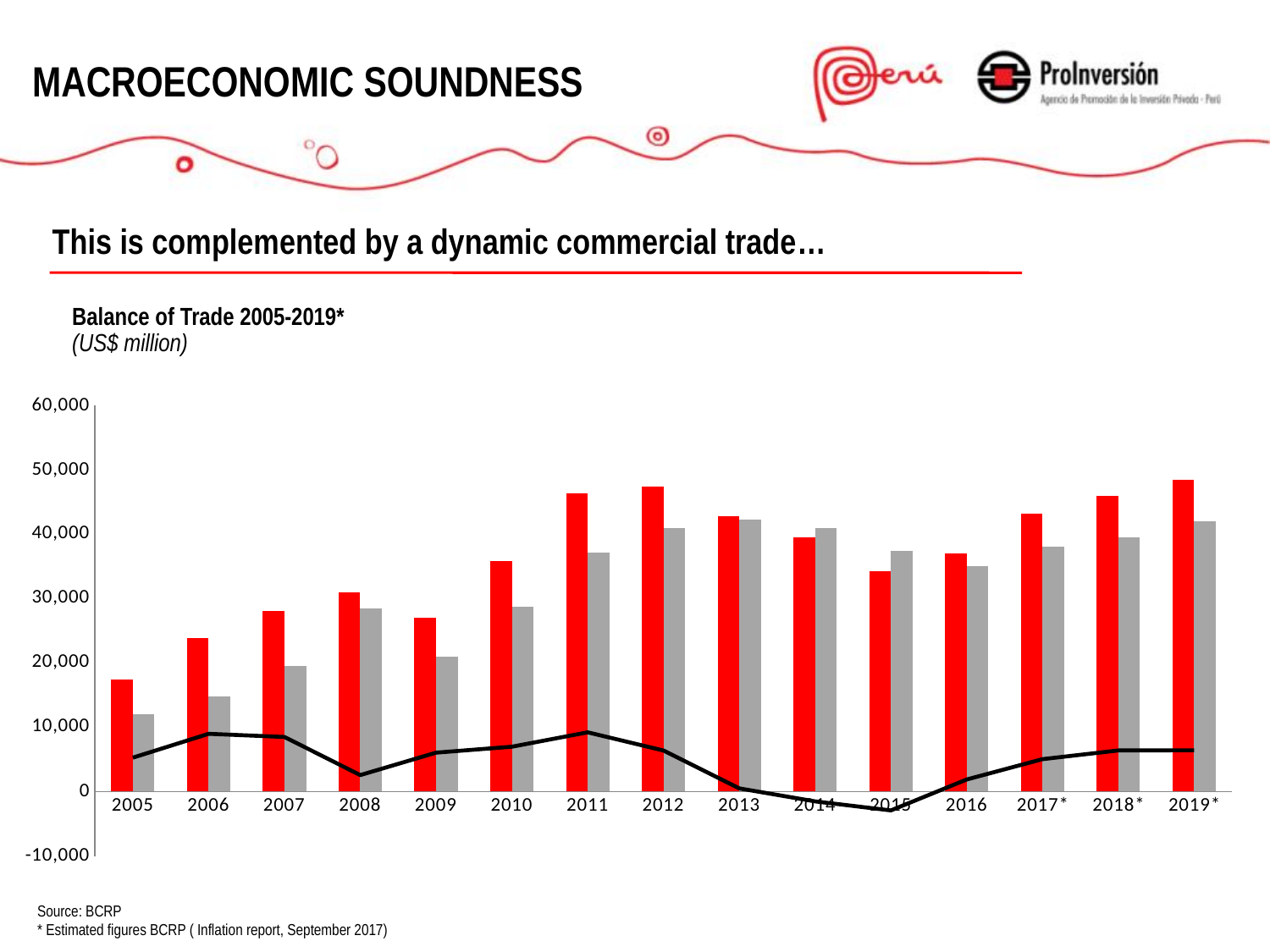
Is the red bar for 2005 greater or less than 20,000? less Which year has the lowest gray bar? 2005 In 2015, which is larger, the red bar or the gray bar? The gray bar What kind of chart is shown on the slide? Bar chart with a line Is the red bar for 2011 greater or less than 40,000? greater Which year has the lowest red bar? 2005 How many years are shown on the x axis of the chart? 15 Do the red bars rise or fall from 2005 to 2008? Rise In what units are the values of the chart expressed? US$ million Is the gray bar for 2016 greater or less than 40,000? less What is the title of the chart? Balance of Trade 2005-2019*